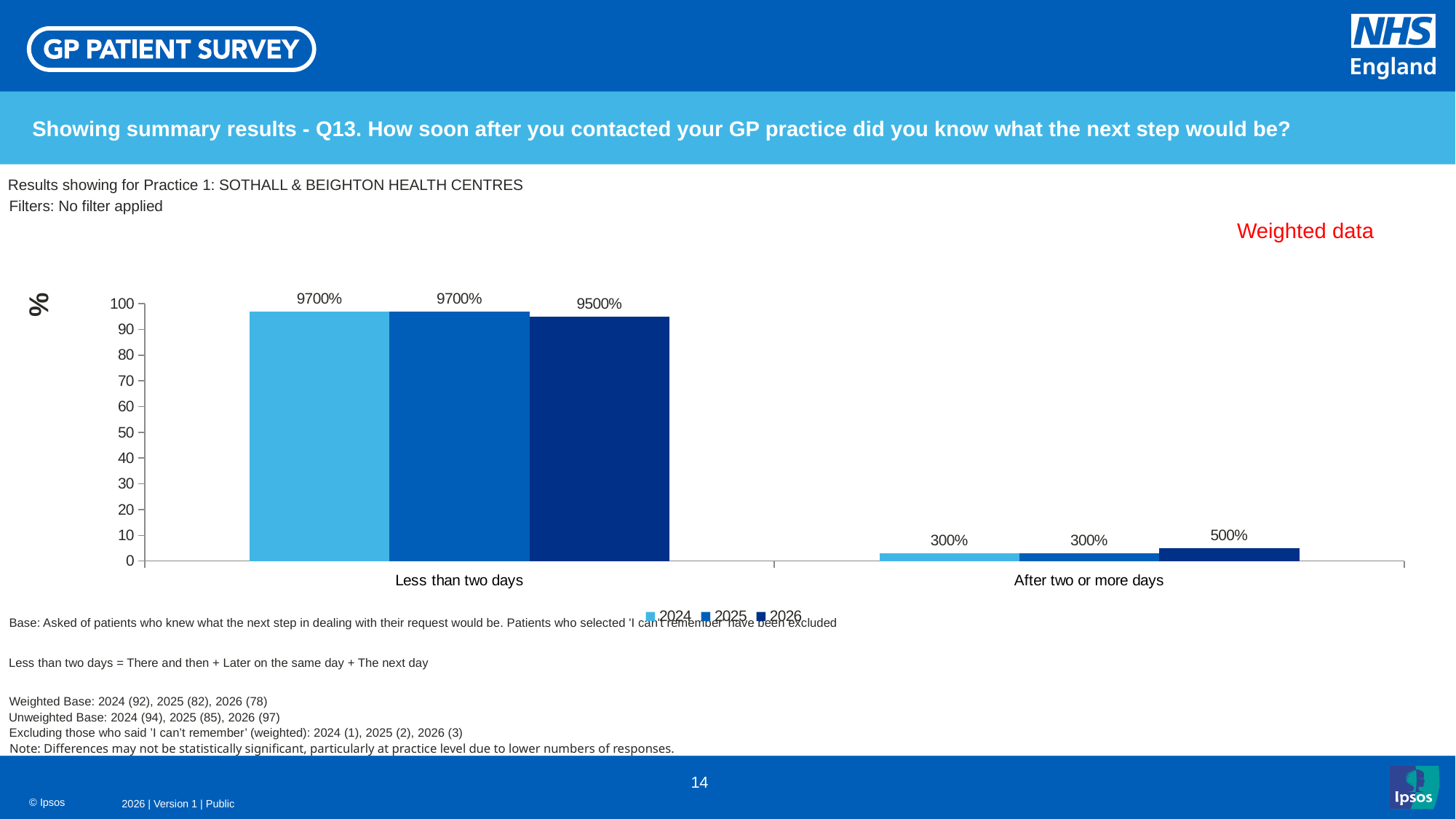
Is the 2026 bar for 'Less than two days' above or below the 90 tick on the y axis? above How many categories are shown on the x axis? 2 Is the 2024 bar for 'Less than two days' larger or smaller than the 2024 bar for 'After two or more days'? larger What kind of chart is shown on the slide? bar chart Which years are listed in the chart legend? 2024, 2025, 2026 What is the data label shown for 2024 in the 'Less than two days' category? 9700% What is the data label shown for 2026 in the 'After two or more days' category? 500% What is the data label shown for 2026 in the 'Less than two days' category? 9500% What is the data label shown for 2025 in the 'After two or more days' category? 300% How many series does the legend list? 3 Which year has the lowest bar in the 'Less than two days' category? 2026 Which year has the highest bar in the 'After two or more days' category? 2026